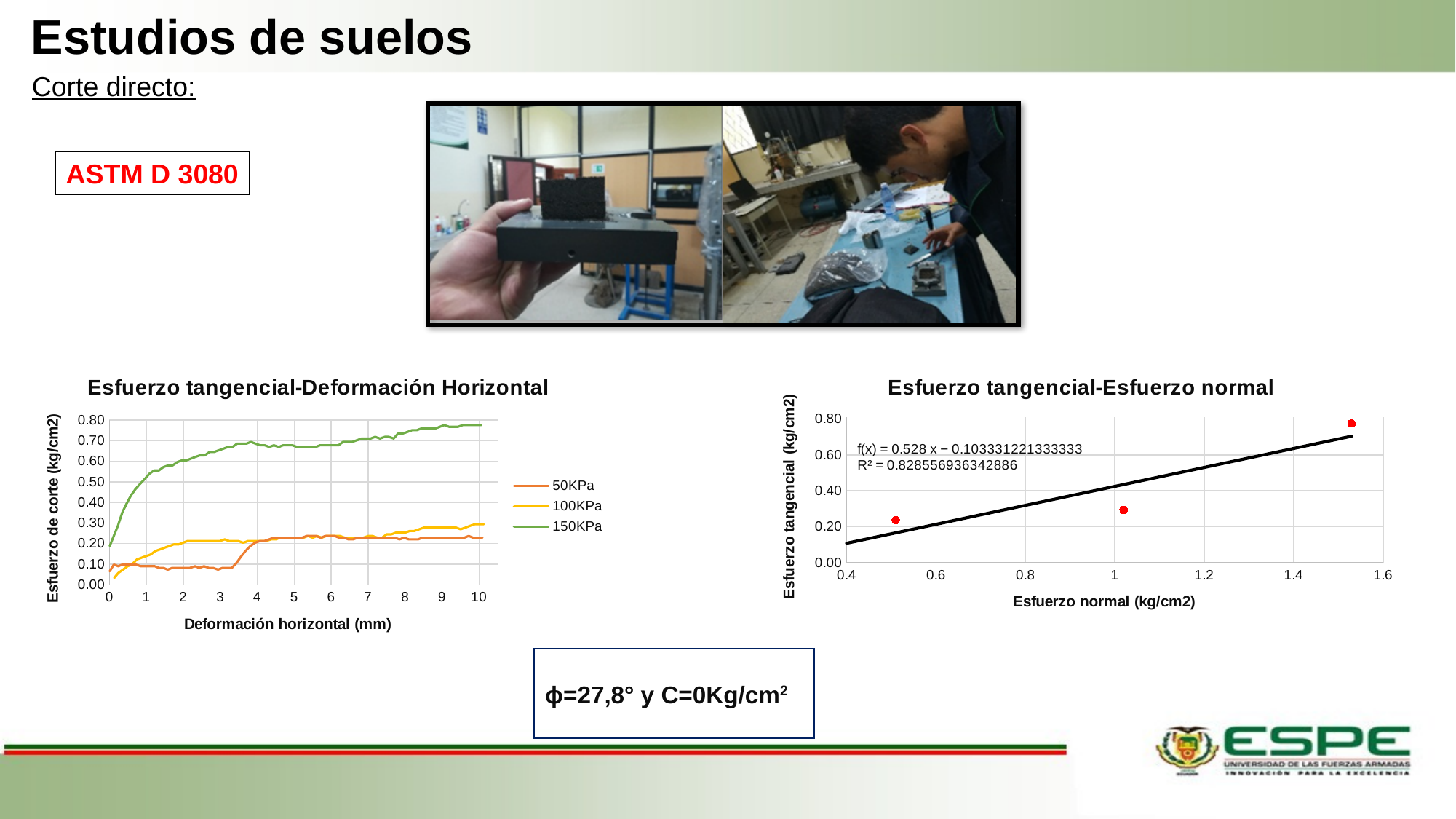
In the chart titled 'Esfuerzo tangencial-Deformación Horizontal', which series has the larger value at 2 mm deformation, 50KPa or 100KPa? 100KPa In the chart titled 'Esfuerzo tangencial-Deformación Horizontal', what kind of chart is it? line chart In the chart titled 'Esfuerzo tangencial-Deformación Horizontal', how many series does the legend list? 3 In the chart titled 'Esfuerzo tangencial-Esfuerzo normal', does the tangential stress rise or fall as normal stress increases? rise In the chart titled 'Esfuerzo tangencial-Deformación Horizontal', what is the label of the x axis? Deformación horizontal (mm) In the chart titled 'Esfuerzo tangencial-Esfuerzo normal', what is the R² value shown for the trendline? 0.828556936342886 In the chart titled 'Esfuerzo tangencial-Deformación Horizontal', which series reaches the highest shear stress values? 150KPa In the chart titled 'Esfuerzo tangencial-Esfuerzo normal', how many data points are plotted? 3 In the chart titled 'Esfuerzo tangencial-Deformación Horizontal', is the value of the 50KPa series at 2 mm deformation greater or less than 0.20? less In the chart titled 'Esfuerzo tangencial-Esfuerzo normal', is the tangential stress of the point at about 1.5 kg/cm2 normal stress greater or less than 0.60? greater In the chart titled 'Esfuerzo tangencial-Deformación Horizontal', does the 150KPa series generally rise or fall as horizontal deformation increases? rise In the chart titled 'Esfuerzo tangencial-Deformación Horizontal', is the value of the 150KPa series at 10 mm deformation greater or less than 0.70? greater